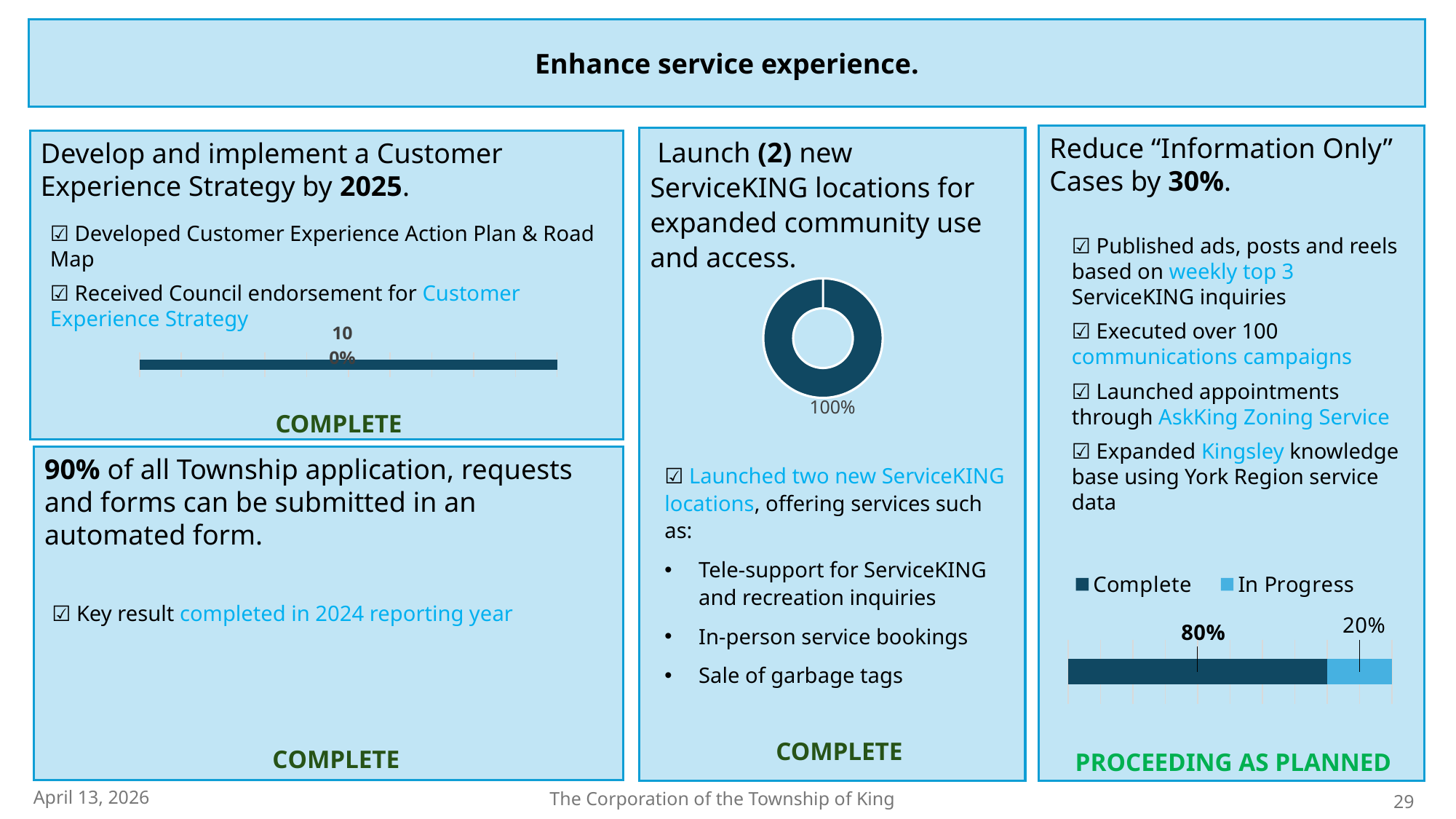
In the chart in the 'Reduce "Information Only" Cases by 30%' panel, what are the two legend entries? Complete and In Progress In the doughnut chart in the 'Launch (2) new ServiceKING locations' panel, how many slices are shown? 1 In the chart in the 'Reduce "Information Only" Cases by 30%' panel, what is the total of the stacked bar? 100% In the doughnut chart in the 'Launch (2) new ServiceKING locations' panel, what value is labelled on the chart? 100% In the chart in the 'Reduce "Information Only" Cases by 30%' panel, what is the value for Complete? 80% In the chart in the 'Reduce "Information Only" Cases by 30%' panel, which series is larger, Complete or In Progress? Complete In the chart in the 'Reduce "Information Only" Cases by 30%' panel, what is the value for In Progress? 20% What kind of chart is shown in the 'Reduce "Information Only" Cases by 30%' panel? Stacked bar chart In the chart in the 'Reduce "Information Only" Cases by 30%' panel, what is the difference between the Complete and In Progress values? 60% What kind of chart is shown in the 'Launch (2) new ServiceKING locations' panel? Doughnut chart In the chart in the 'Reduce "Information Only" Cases by 30%' panel, which series is shown in the lighter blue colour? In Progress In the chart in the 'Reduce "Information Only" Cases by 30%' panel, how many series does the legend list? 2